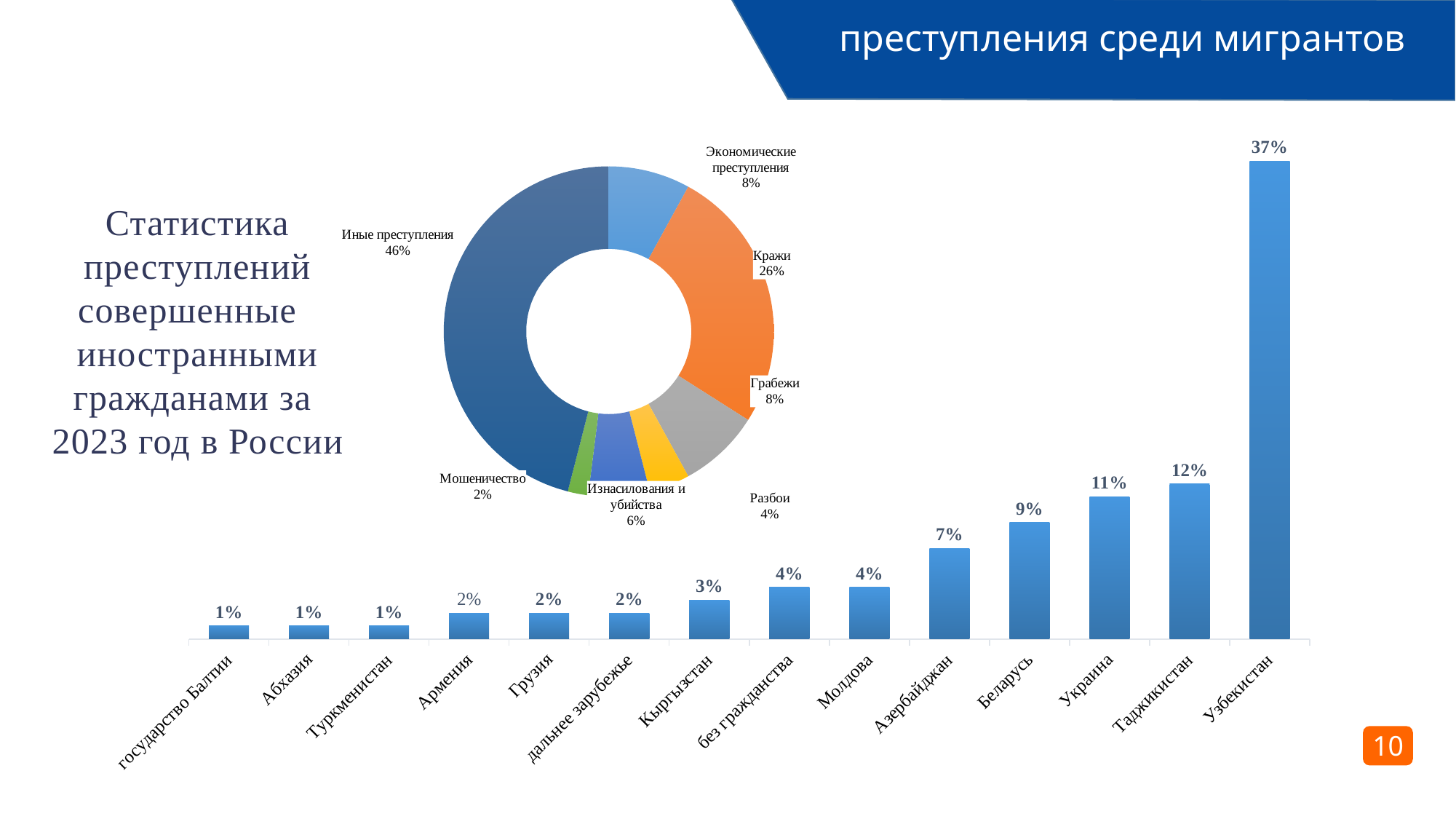
In the bar chart at the bottom, what is the value for Таджикистан? 12% In the doughnut chart, what is the difference between the shares for Кражи and Грабежи? 18% What kind of chart is the one at the bottom of the slide? Bar chart In the doughnut chart, how many categories are shown? 7 In the doughnut chart, which category has the largest share? Иные преступления In the bar chart at the bottom, which category has the highest value? Узбекистан In the doughnut chart, which category has the smallest share? Мошеничество In the bar chart at the bottom, what is the difference between the values for Узбекистан and Украина? 26% In the bar chart at the bottom, how many categories are shown? 14 In the doughnut chart, what share is labelled for Кражи? 26% In the bar chart at the bottom, which is larger, the value for Беларусь or the value for Азербайджан? Беларусь In the doughnut chart, what share is labelled for Изнасилования и убийства? 6%